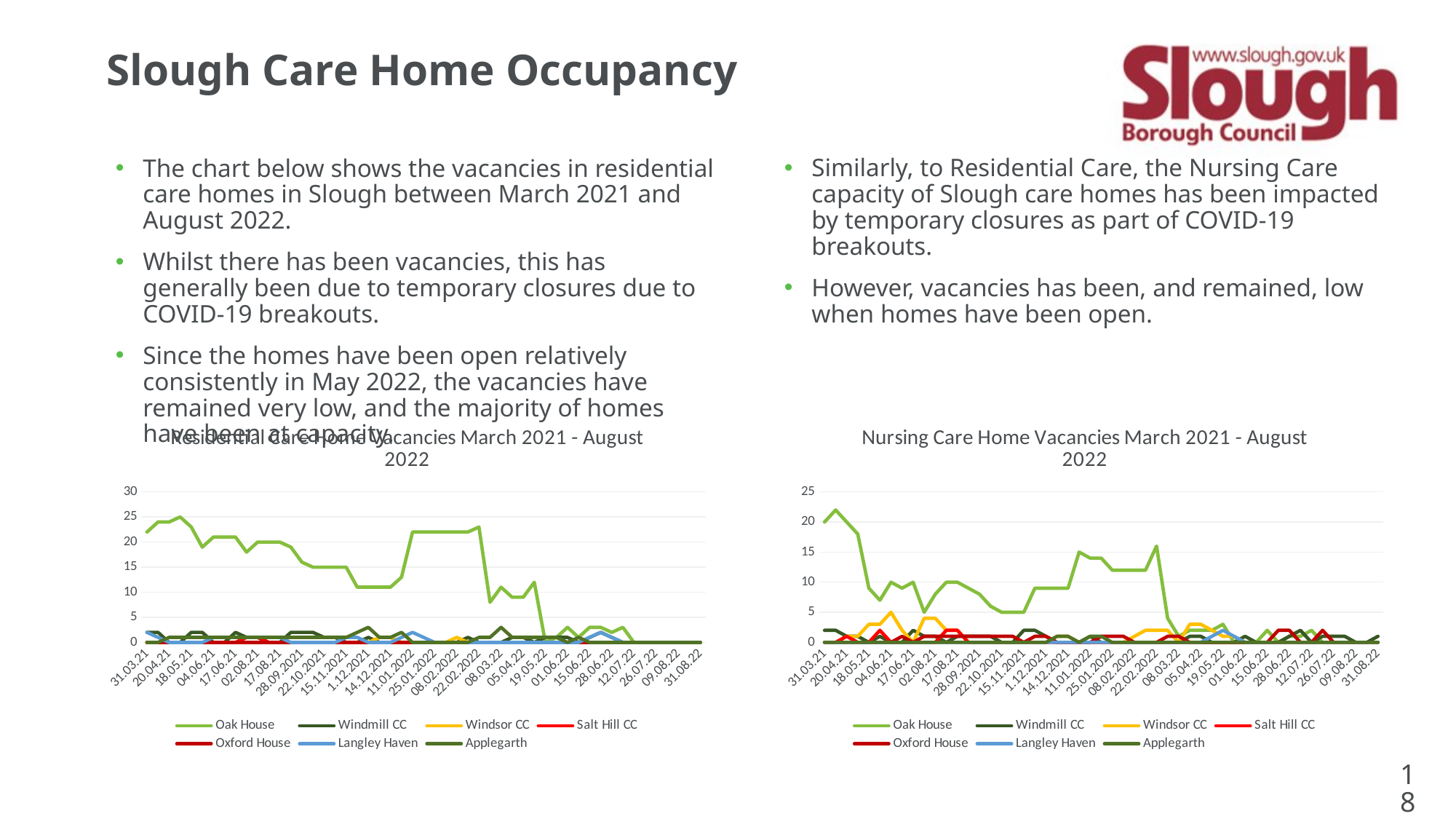
How many series does the legend of the Nursing Care Home Vacancies chart list? 7 In the Nursing Care Home Vacancies chart, is the value for Oak House at 15.11.2021 greater or less than 10? less In the Nursing Care Home Vacancies chart, which series has the highest values over most of the period? Oak House What kind of chart is the Residential Care Home Vacancies March 2021 - August 2022 chart? Line chart In the Residential Care Home Vacancies chart, is the value for Oak House at 31.03.21 greater or less than 20? greater In the Residential Care Home Vacancies chart, is the value for Oak House at 14.12.2021 greater or less than 15? less In the Residential Care Home Vacancies chart, does the Oak House line overall rise or fall from 31.03.21 to 31.08.22? Fall What kind of chart is the Nursing Care Home Vacancies March 2021 - August 2022 chart? Line chart What is the title of the chart on the right of the slide? Nursing Care Home Vacancies March 2021 - August 2022 In the Residential Care Home Vacancies chart, which series has the highest values over most of the period? Oak House How many series does the legend of the Residential Care Home Vacancies chart list? 7